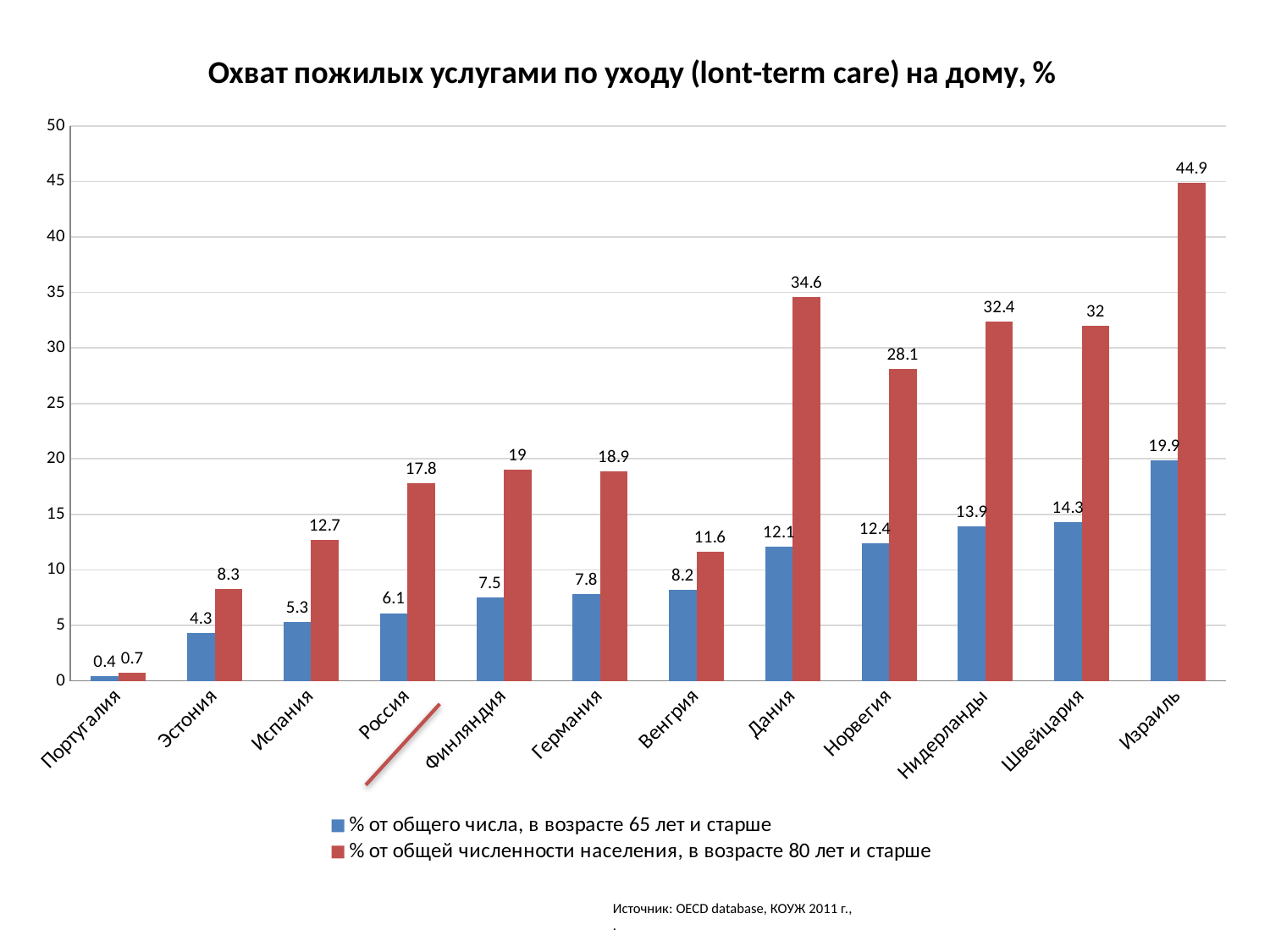
Which is larger: the 80+ series value for Нидерланды or for Швейцария? Нидерланды How many countries are shown on the x axis? 12 Which country has the lowest value in the series "% от общего числа, в возрасте 65 лет и старше"? Португалия What is the difference between the two series values for Израиль? 25 Is the 80+ series value for Норвегия greater or less than 25? greater What is the title of the chart? Охват пожилых услугами по уходу (lont-term care) на дому, % What is the value for Россия in the series "% от общего числа, в возрасте 65 лет и старше"? 6.1 How many series does the legend list? 2 Do the values of the series "% от общего числа, в возрасте 65 лет и старше" generally rise or fall from left to right along the x axis? rise Which country has the highest value in the series "% от общей численности населения, в возрасте 80 лет и старше"? Израиль What kind of chart is shown on the slide? bar chart What is the value for Дания in the series "% от общей численности населения, в возрасте 80 лет и старше"? 34.6